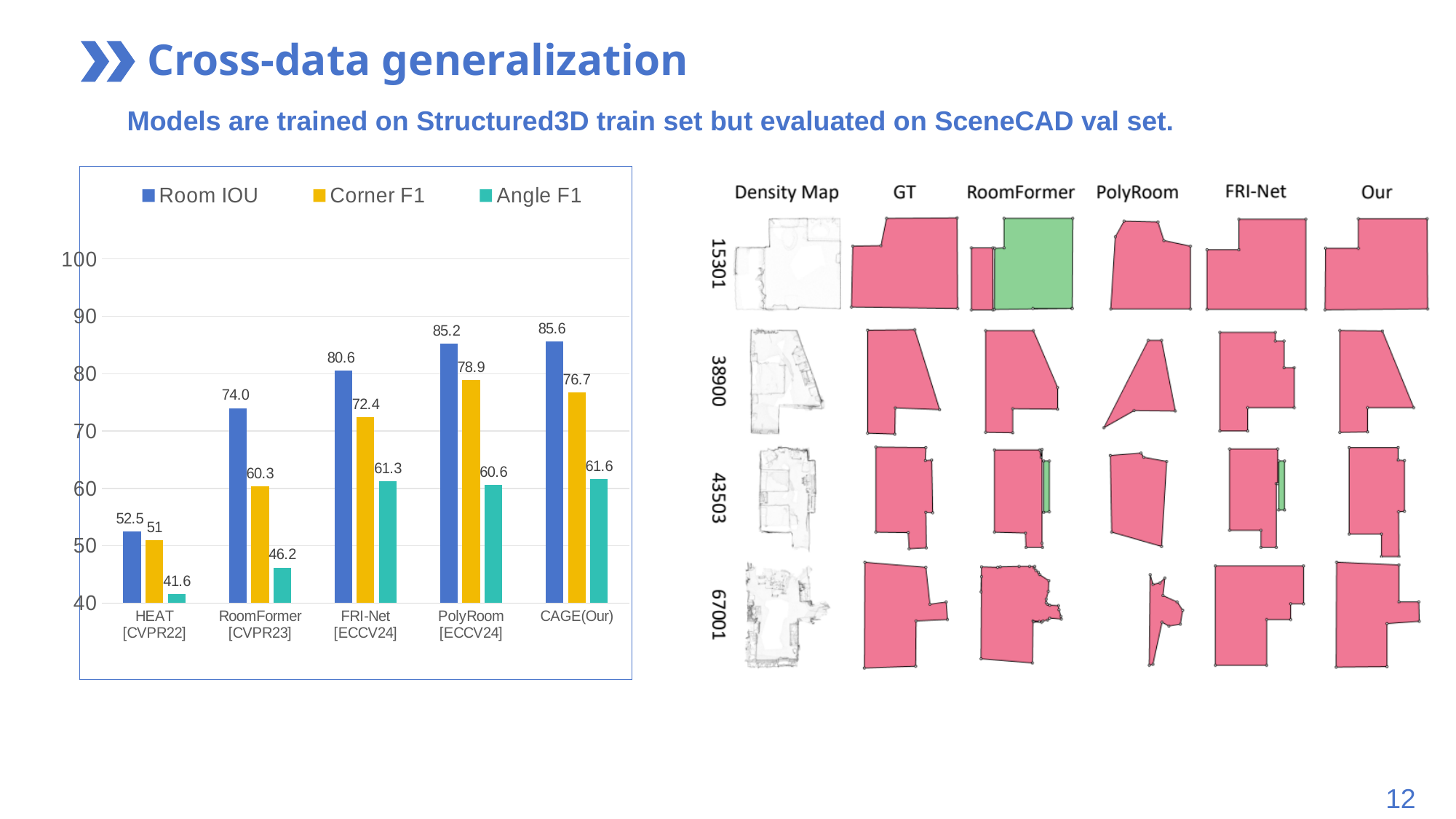
What is the Angle F1 value for HEAT [CVPR22]? 41.6 What is the difference between the Corner F1 of PolyRoom [ECCV24] and CAGE(Our)? 2.2 Which method has the highest Room IOU? CAGE(Our) Which has the higher Corner F1, PolyRoom [ECCV24] or CAGE(Our)? PolyRoom [ECCV24] What kind of chart is shown on the slide? bar chart What is the Corner F1 value for PolyRoom [ECCV24]? 78.9 Which method has the lowest Angle F1? HEAT [CVPR22] Does the Room IOU rise or fall from HEAT [CVPR22] to CAGE(Our) along the x axis? rises How many methods are compared on the x axis of the chart? 5 What is the difference in Room IOU between CAGE(Our) and HEAT [CVPR22]? 33.1 How many series does the chart legend list? 3 What is the Room IOU value for FRI-Net [ECCV24]? 80.6